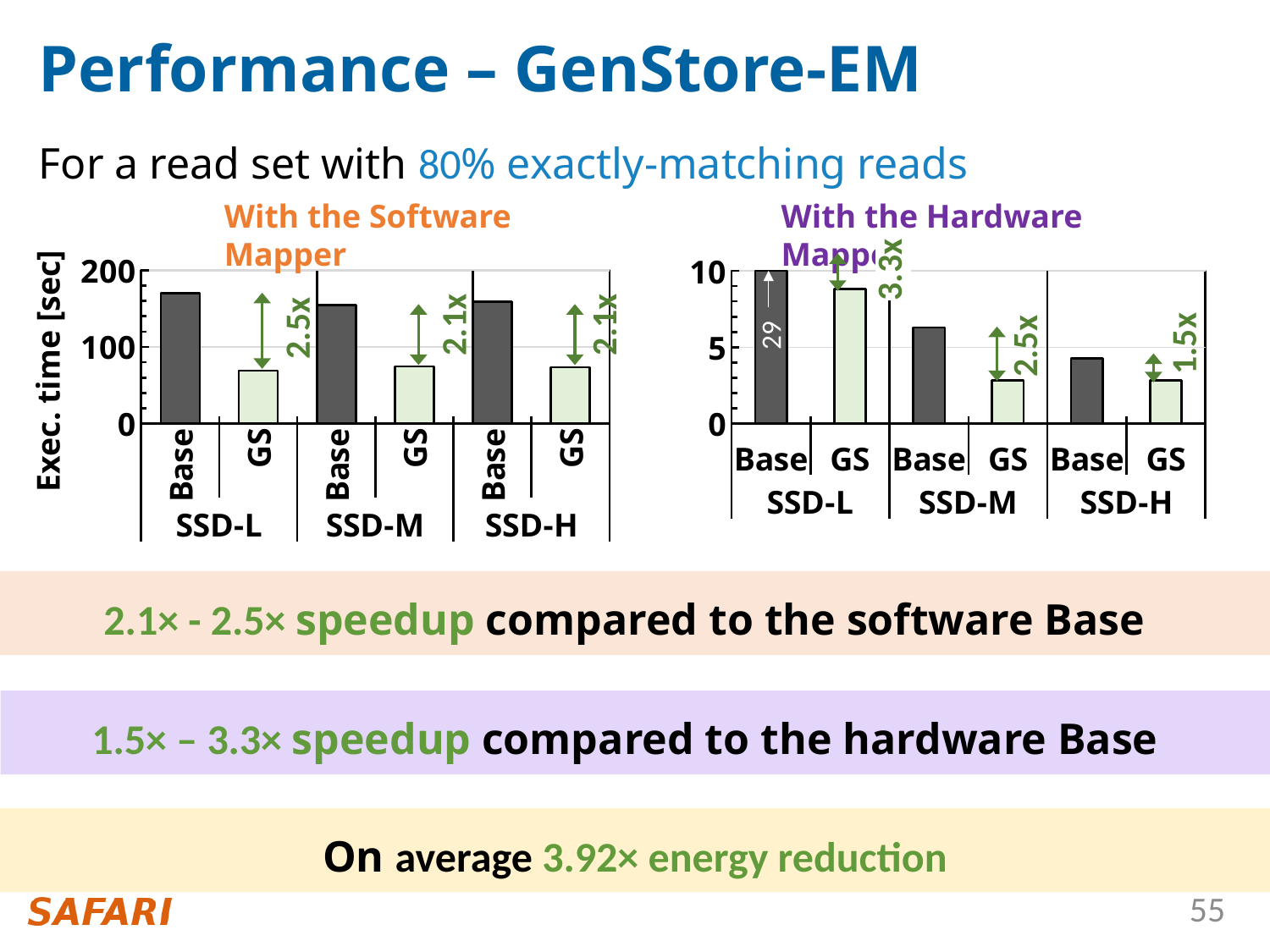
In the 'With the Hardware Mapper' chart, is the value for GS on SSD-H greater or less than 5? less How many SSD configurations are shown in the 'With the Software Mapper' chart? 3 In the 'With the Hardware Mapper' chart, is the value for Base on SSD-M greater or less than 5? greater In the 'With the Software Mapper' chart, what speedup is annotated for SSD-L? 2.5x In the 'With the Software Mapper' chart, is the value for Base on SSD-L greater or less than 100? greater In the 'With the Hardware Mapper' chart, which bar has the highest execution time? Base on SSD-L What kind of chart is used in the 'With the Software Mapper' panel? bar chart In the 'With the Software Mapper' chart, which is larger for SSD-H: Base or GS? Base In the 'With the Hardware Mapper' chart, what speedup is annotated for SSD-H? 1.5x In the 'With the Hardware Mapper' chart, what is the execution time of Base for SSD-L? 29 In the 'With the Hardware Mapper' chart, what speedup is annotated for SSD-L? 3.3x